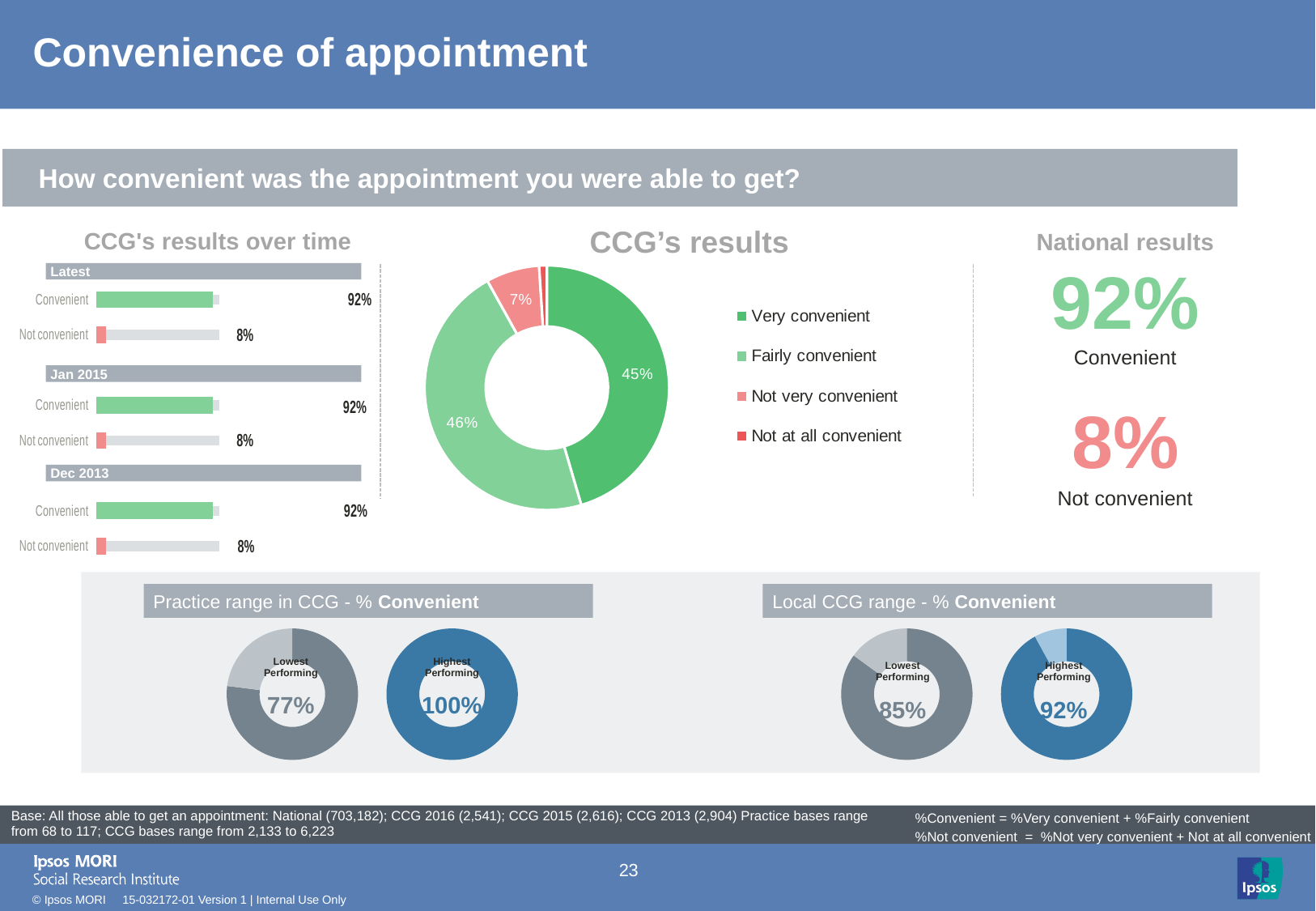
In the "CCG's results" donut chart, what percentage is shown for Not very convenient? 7% In the "CCG's results over time" chart, what is the Not convenient value for Dec 2013? 8% In the "CCG's results" donut chart, what percentage is shown for Very convenient? 45% In the "CCG's results" donut chart, which category has the smallest share? Not at all convenient What kind of chart is "CCG's results over time"? Bar chart In the "CCG's results over time" chart, does the Convenient value rise, fall or stay the same from Dec 2013 to Latest? Stays the same In the "CCG's results" donut chart, what is the difference between the Fairly convenient and Not very convenient percentages? 39% In the "CCG's results" donut chart, how many categories does the legend list? 4 In the "CCG's results over time" chart, what is the Convenient value for Jan 2015? 92% In the "Local CCG range - % Convenient" section, what is the difference between the Highest Performing and Lowest Performing values? 7% In the "Practice range in CCG - % Convenient" section, what is the Highest Performing value? 100% In the "CCG's results" donut chart, what percentage is shown for Fairly convenient? 46%